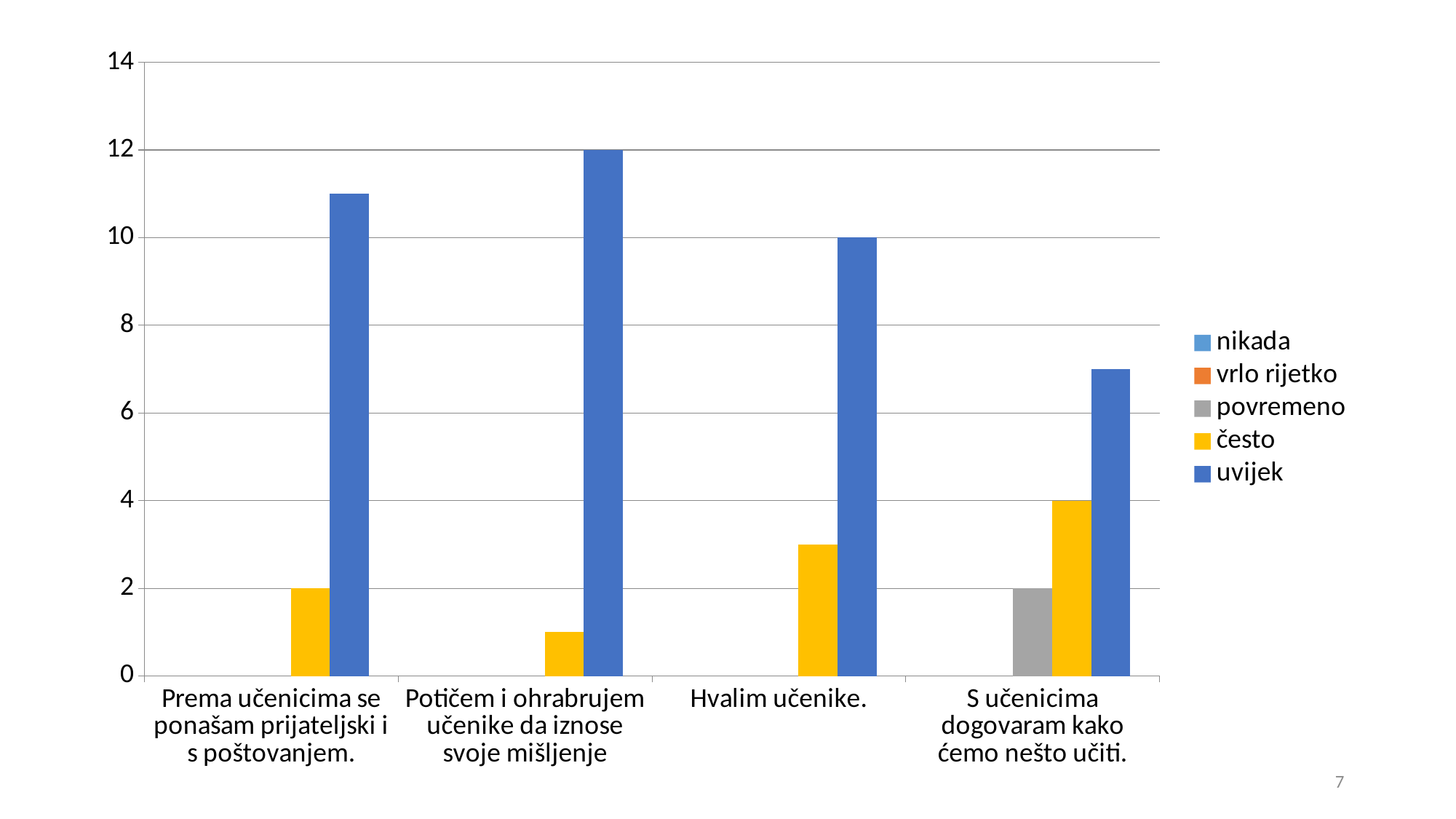
What is the value of 'uvijek' for 'Hvalim učenike.'? 10 Which category has the lowest 'uvijek' value? S učenicima dogovaram kako ćemo nešto učiti. What is the value of 'uvijek' for 'Potičem i ohrabrujem učenike da iznose svoje mišljenje'? 12 What kind of chart is shown on the slide? bar chart Which category has the highest 'uvijek' value? Potičem i ohrabrujem učenike da iznose svoje mišljenje How many categories are shown on the x axis? 4 How many series does the legend list? 5 Is the 'uvijek' value for 'Prema učenicima se ponašam prijateljski i s poštovanjem.' greater or less than 10? greater What is the value of 'često' for 'S učenicima dogovaram kako ćemo nešto učiti.'? 4 What is the value of 'često' for 'Prema učenicima se ponašam prijateljski i s poštovanjem.'? 2 Which is larger: the 'često' value for 'Hvalim učenike.' or the 'često' value for 'Potičem i ohrabrujem učenike da iznose svoje mišljenje'? Hvalim učenike. What is the value of 'povremeno' for 'S učenicima dogovaram kako ćemo nešto učiti.'? 2